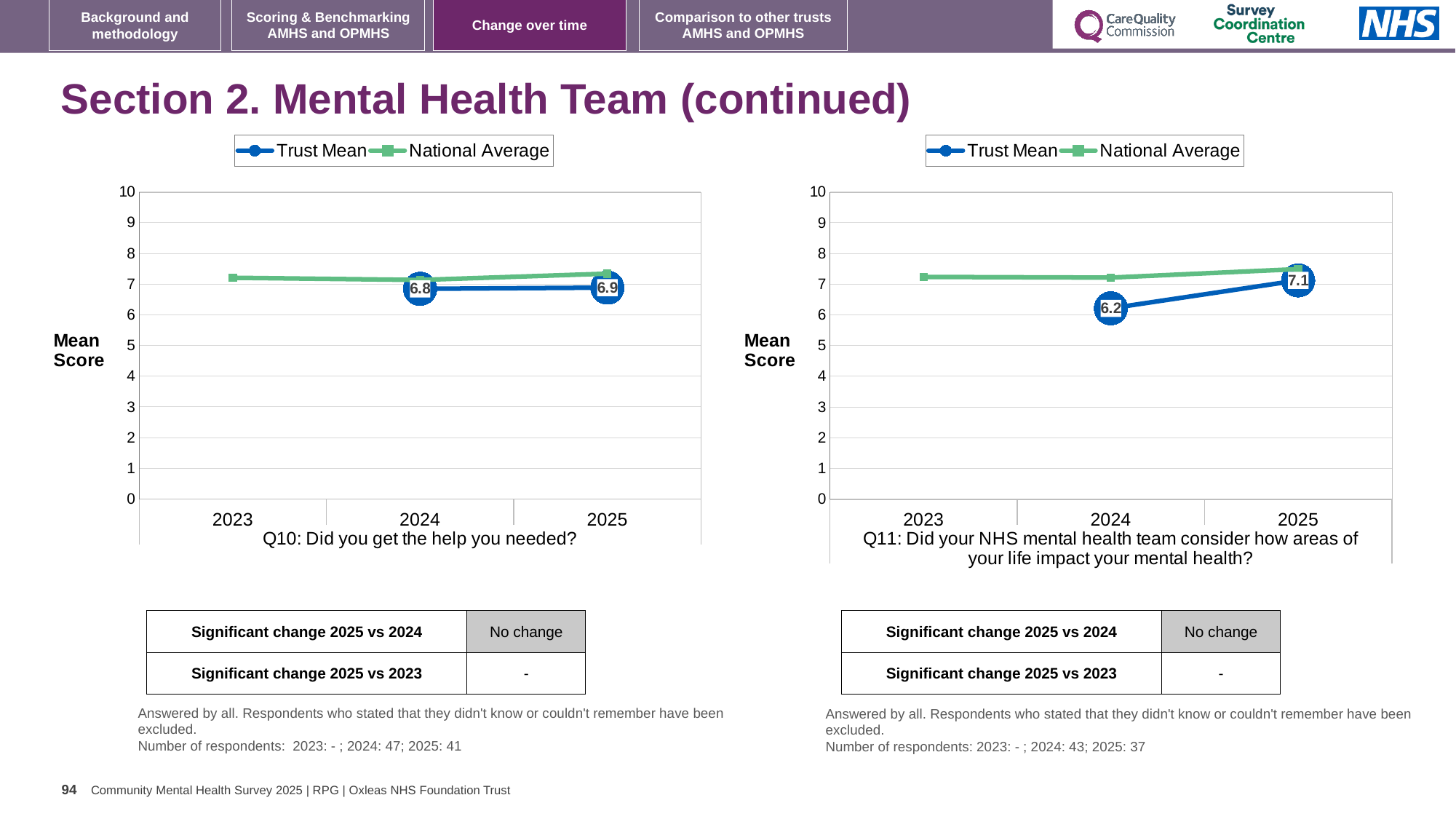
In the Q11 chart (right), what is the Trust Mean score for 2024? 6.2 In the Q11 chart (right), which is larger in 2024: the Trust Mean or the National Average? National Average In the Q11 chart (right), by how much did the Trust Mean change from 2024 to 2025? 0.9 How many series does the legend of the Q11 chart (right) list? 2 In the Q10 chart (left), what is the difference between the Trust Mean for 2025 and 2024? 0.1 In the Q11 chart (right), is the Trust Mean for 2024 greater or less than 7? less What type of chart is the Q10 chart (left)? line chart In the Q10 chart (left), what is the Trust Mean score for 2024? 6.8 In the Q10 chart (left), what is the Trust Mean score for 2025? 6.9 In the Q11 chart (right), does the Trust Mean rise or fall from 2024 to 2025? rise In the Q11 chart (right), what is the Trust Mean score for 2025? 7.1 How many years are shown on the x axis of the Q10 chart (left)? 3